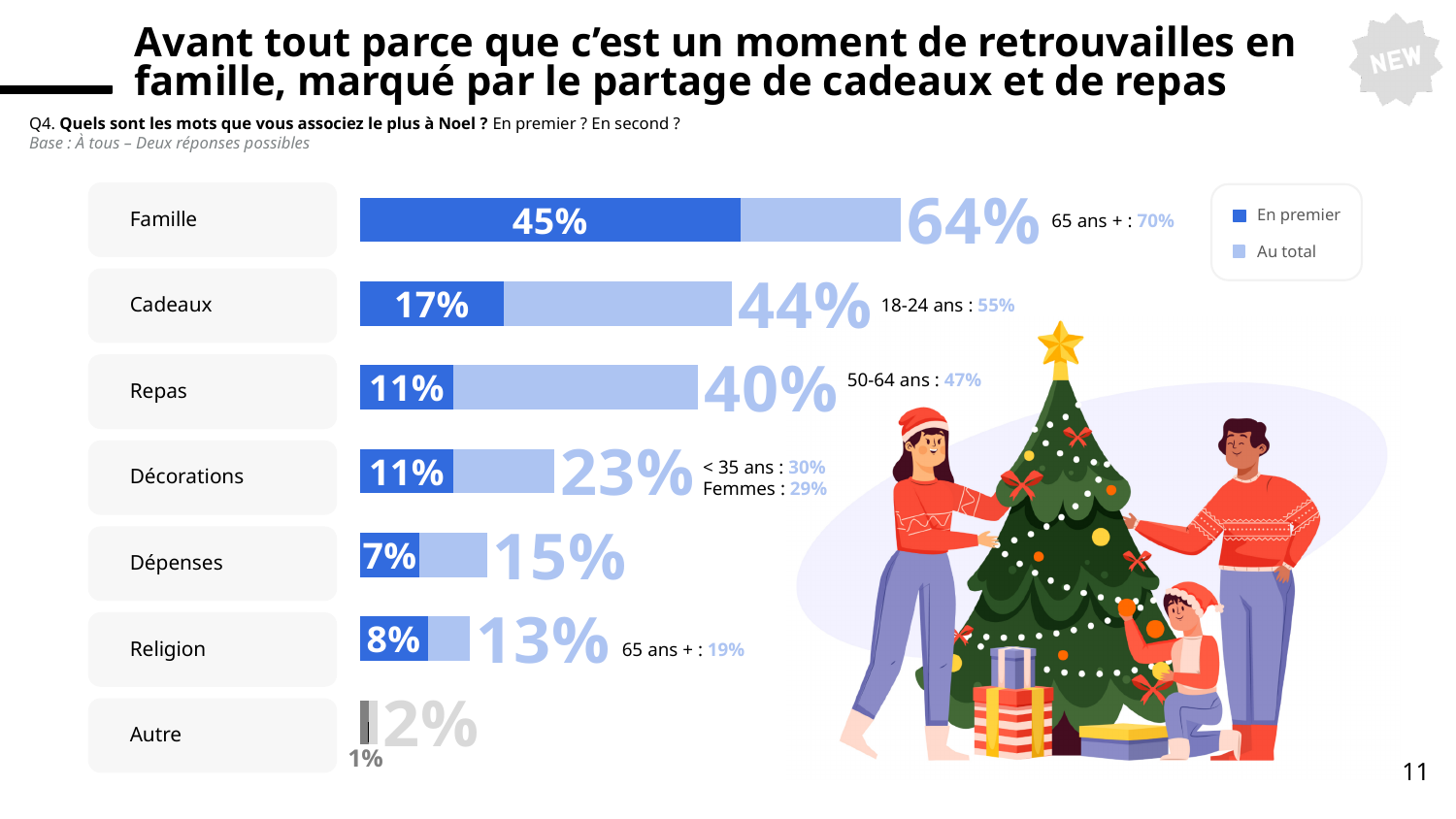
What is the 'En premier' value for Cadeaux? 17% What is the 'Au total' value for Repas? 40% What kind of chart is shown on the slide? Bar chart Which category has the highest 'Au total' value? Famille How many categories are shown in the chart? 7 What is the difference between the 'En premier' and 'Au total' values for Décorations? 12% Which category has the lowest 'Au total' value? Autre What is the 'Au total' value for Famille? 64% What is the difference between the 'Au total' values for Famille and Cadeaux? 20% What is the 'En premier' value for Religion? 8% How many series does the legend list? 2 Which is larger, the 'En premier' value for Dépenses or for Religion? Religion